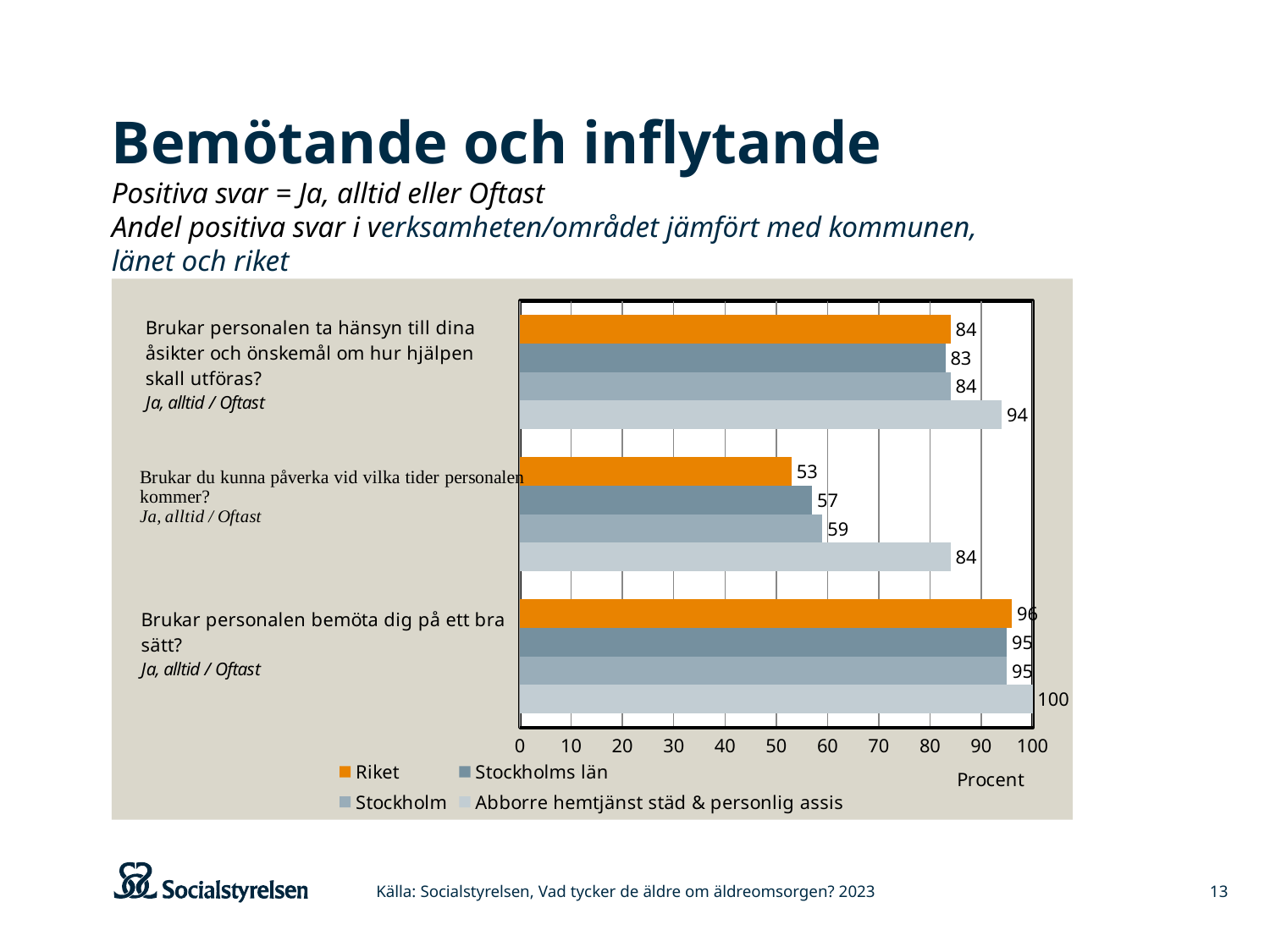
What label is shown on the horizontal axis of the chart? Procent What is the value for Abborre hemtjänst städ & personlig assis on the question "Brukar personalen bemöta dig på ett bra sätt?" 100 On the question "Brukar personalen ta hänsyn till dina åsikter och önskemål om hur hjälpen skall utföras?", which is larger: the value for Abborre hemtjänst städ & personlig assis or the value for Riket? Abborre hemtjänst städ & personlig assis How many series does the legend list? 4 What is the value for Stockholms län on the question "Brukar personalen ta hänsyn till dina åsikter och önskemål om hur hjälpen skall utföras?" 83 Which series has the lowest value on the question "Brukar du kunna påverka vid vilka tider personalen kommer?" Riket How many question categories are plotted on the chart? 3 What is the difference between Abborre hemtjänst städ & personlig assis and Riket on the question "Brukar du kunna påverka vid vilka tider personalen kommer?" 31 What is the value for Riket on the question "Brukar du kunna påverka vid vilka tider personalen kommer?" 53 What kind of chart is shown on the slide? Bar chart What is the value for Stockholm on the question "Brukar du kunna påverka vid vilka tider personalen kommer?" 59 Which series has the highest value on the question "Brukar du kunna påverka vid vilka tider personalen kommer?" Abborre hemtjänst städ & personlig assis